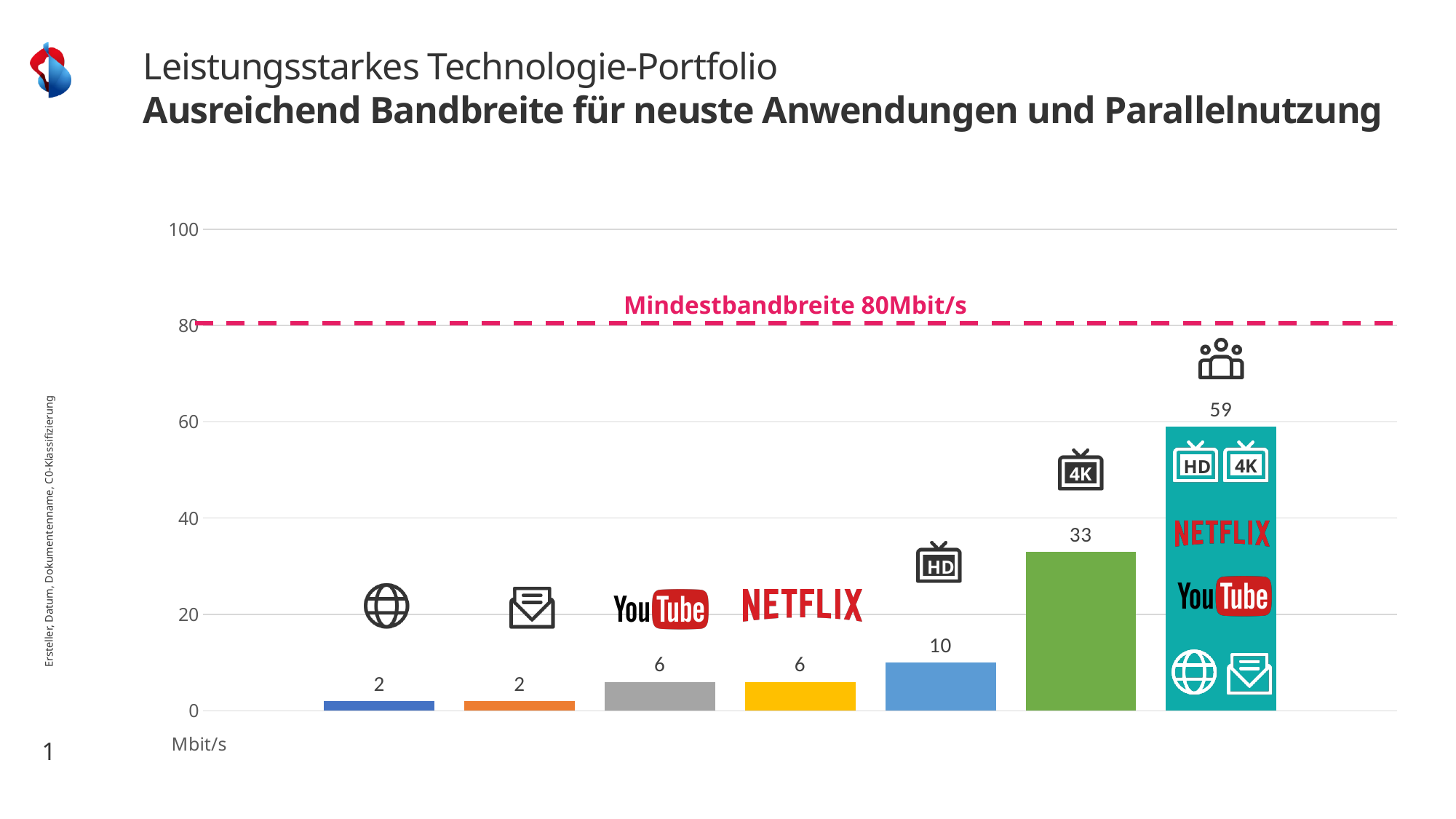
What value is shown for the bar with the globe icon? 2 What kind of chart is shown on the slide? Bar chart Is the value of the rightmost bar greater or less than the 80 Mbit/s dashed line? less Which bar has the highest value? The rightmost bar (group-of-people icon), 59 What does the dashed horizontal line in the chart represent? Mindestbandbreite 80Mbit/s What value is shown for the bar with the HD TV icon? 10 Which is larger, the Netflix bar or the HD TV bar? HD TV bar What is the difference between the 4K TV bar and the HD TV bar? 23 What value is shown for the rightmost bar (the one with the group-of-people icon)? 59 What value is shown for the YouTube bar? 6 How many bars are plotted in the chart? 7 What value is shown for the bar with the 4K TV icon? 33